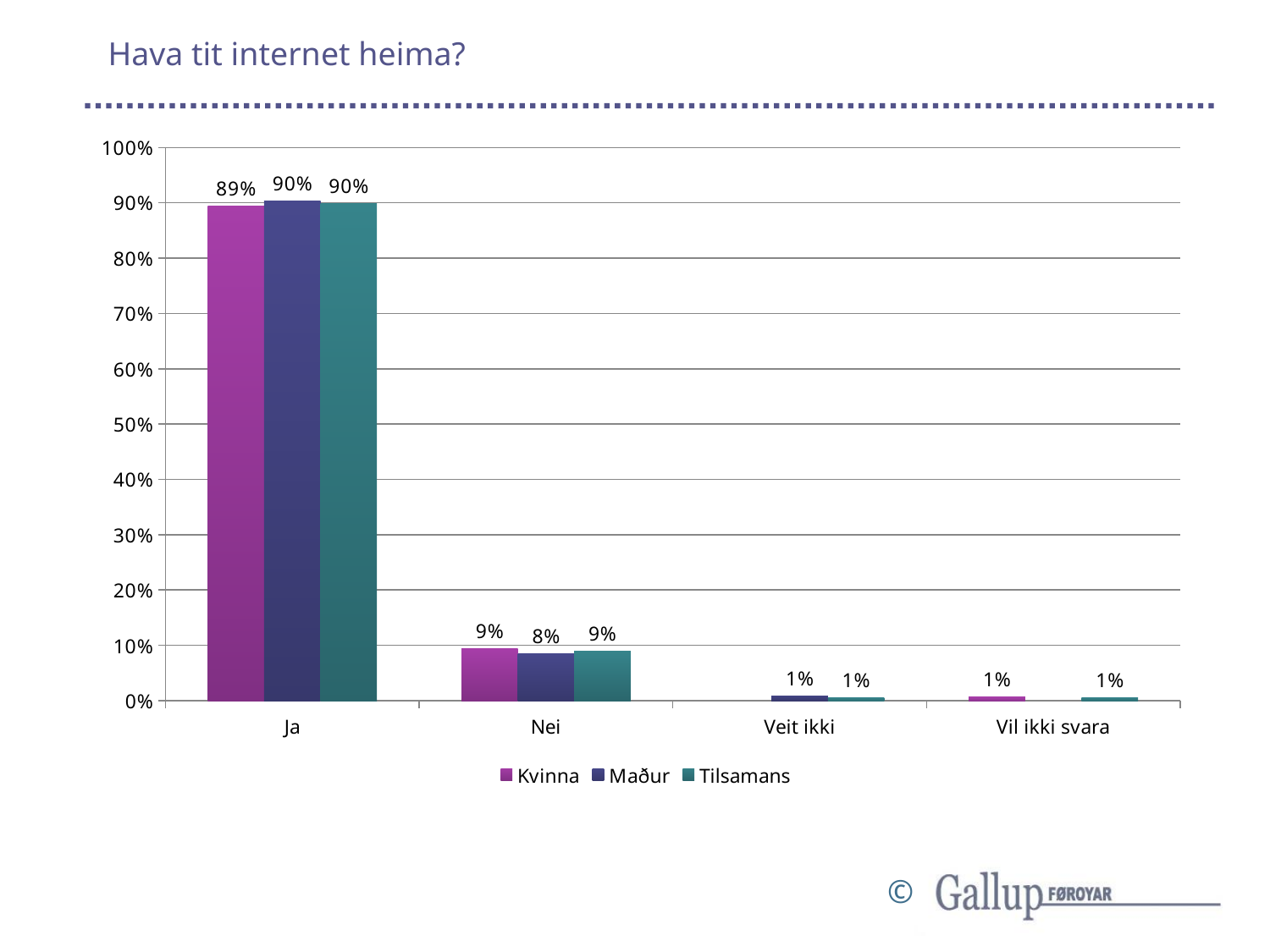
What is the value for Kvinna in the Ja category? 89% Which is larger in the Ja category, the value for Kvinna or the value for Maður? Maður What is the value for Kvinna in the Nei category? 9% What is the difference between the Maður and Kvinna values in the Ja category? 1% What is the title of the chart? Hava tit internet heima? Which category has the highest value for Tilsamans? Ja What is the value for Maður in the Nei category? 8% What is the difference between the Kvinna and Maður values in the Nei category? 1% What is the value for Tilsamans in the Ja category? 90% How many series does the legend list? 3 How many categories are shown on the x axis? 4 What kind of chart is shown on the slide? Bar chart